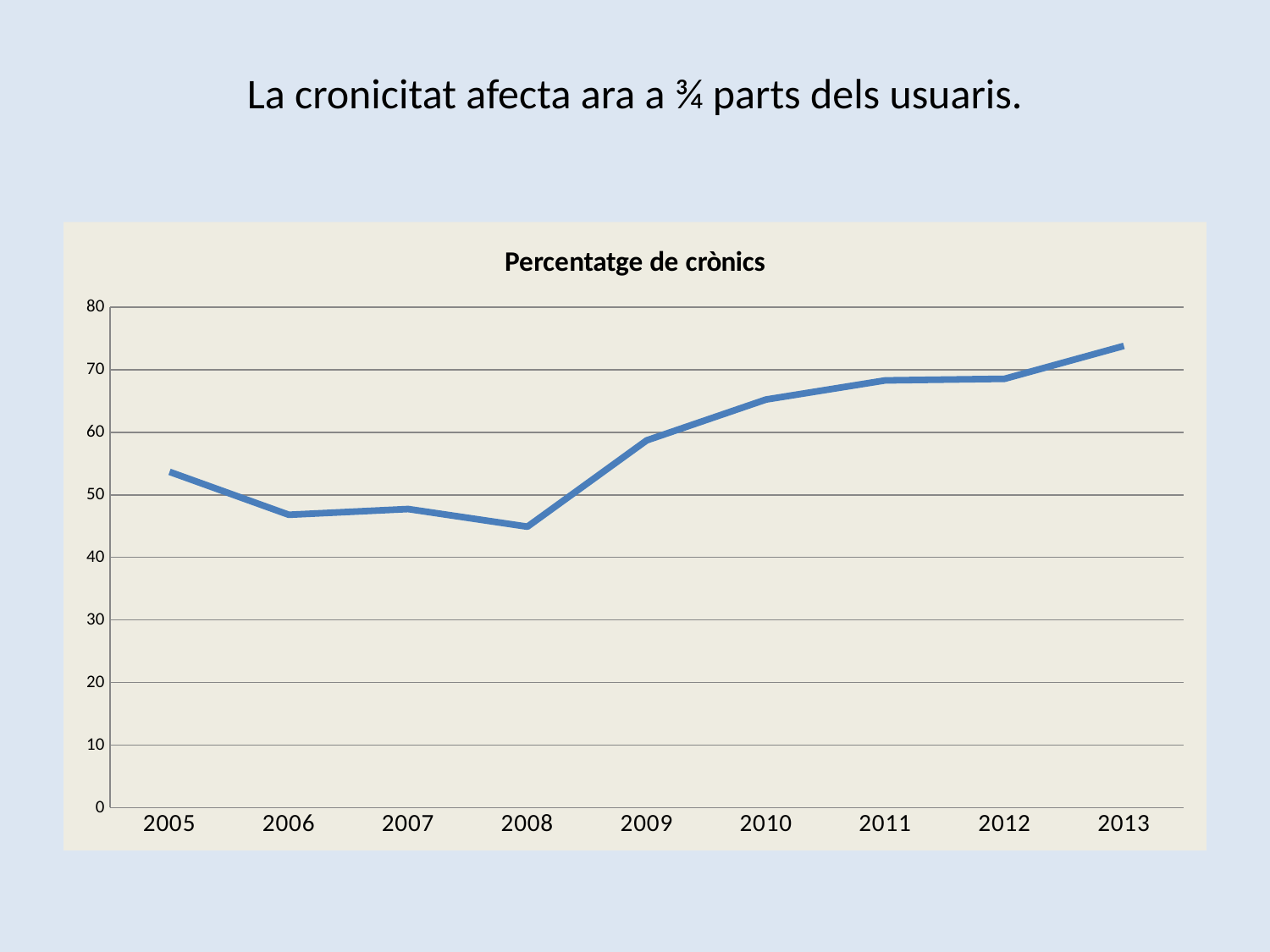
In which year is the percentage of chronic patients lowest? 2008 In which year is the percentage of chronic patients highest? 2013 Which year has the larger value, 2005 or 2013? 2013 Is the value for 2008 greater or less than 50? less Does the percentage of chronic patients rise or fall between 2008 and 2013? rise What is the title of the chart? Percentatge de crònics What kind of chart is shown on the slide? line chart Which year has the larger value, 2008 or 2009? 2009 How many years are plotted on the x axis of the chart? 9 Is the value for 2005 greater or less than 50? greater Is the value for 2013 greater or less than 70? greater